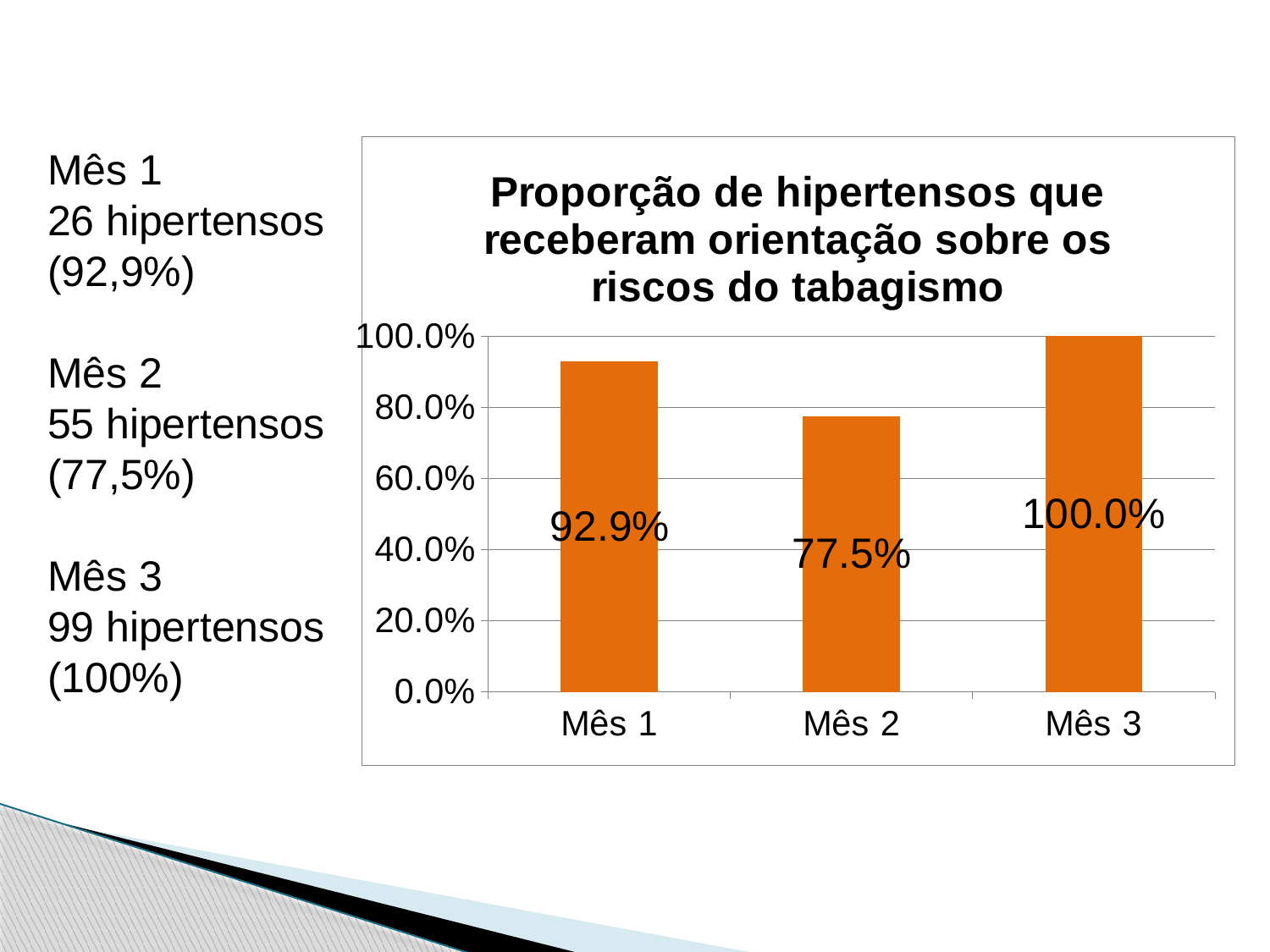
What is the difference between the values for Mês 3 and Mês 2? 22.5% Which month has the lowest value? Mês 2 Which is larger, the value for Mês 1 or the value for Mês 2? Mês 1 How many months are shown on the x axis? 3 What kind of chart is shown on the slide? bar chart What is the difference between the values for Mês 1 and Mês 2? 15.4% What is the value for Mês 1? 92.9% Is the value for Mês 2 greater or less than 80.0%? less What is the title of the chart? Proporção de hipertensos que receberam orientação sobre os riscos do tabagismo What is the value for Mês 2? 77.5% What is the value for Mês 3? 100.0% Which month has the highest value? Mês 3